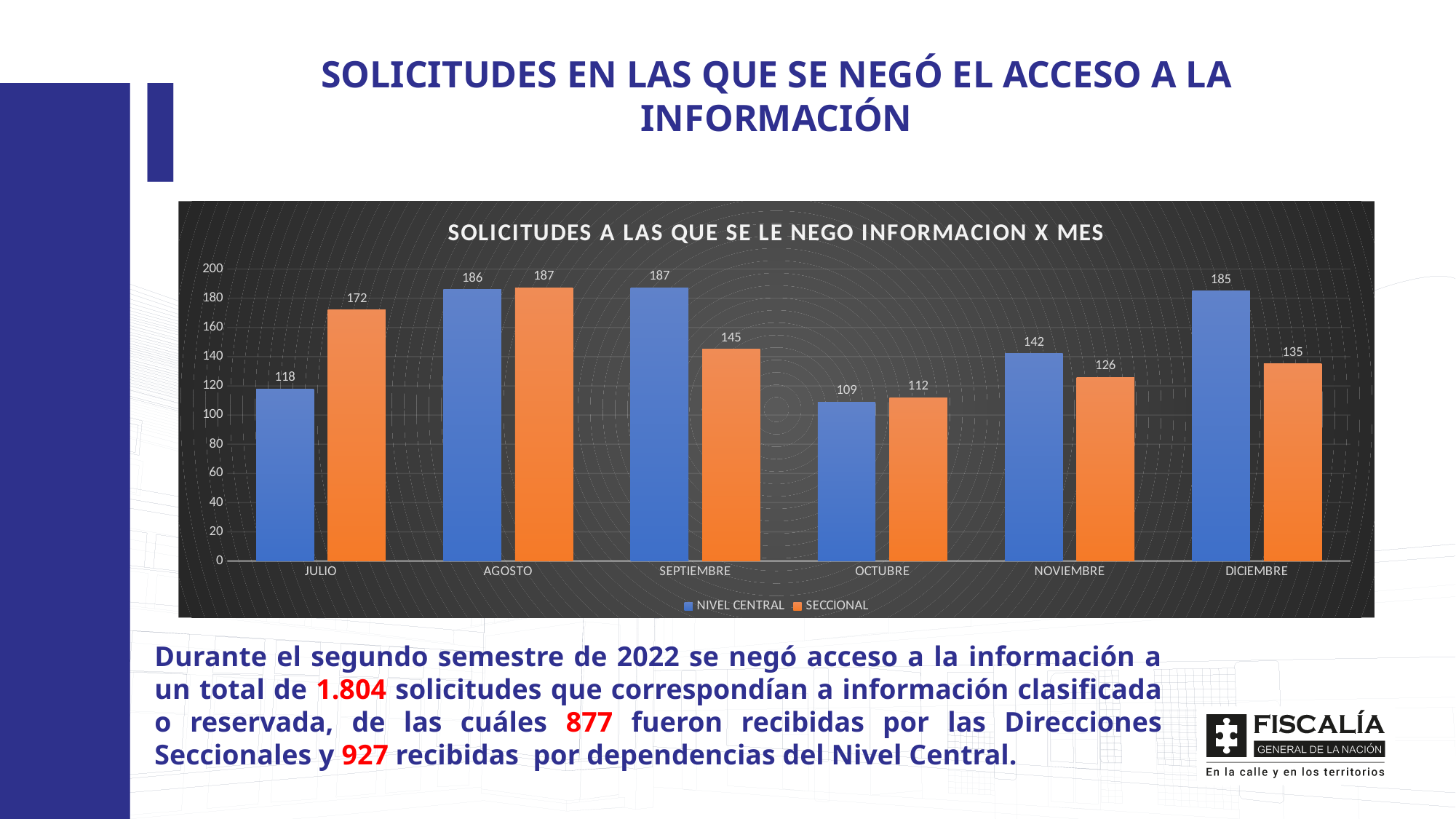
What is the value for SECCIONAL in SEPTIEMBRE? 145 Which month has the highest value for SECCIONAL? AGOSTO Do the SECCIONAL values rise or fall from AGOSTO to OCTUBRE? fall Which month has the lowest value for NIVEL CENTRAL? OCTUBRE Is the value for NIVEL CENTRAL in OCTUBRE greater or less than 120? less In NOVIEMBRE, which series has the larger value, NIVEL CENTRAL or SECCIONAL? NIVEL CENTRAL How many series does the legend list? 2 What is the value for SECCIONAL in DICIEMBRE? 135 What is the difference between SECCIONAL and NIVEL CENTRAL in JULIO? 54 What is the value for NIVEL CENTRAL in JULIO? 118 What kind of chart is shown on the slide? bar chart How many months are shown on the x axis? 6